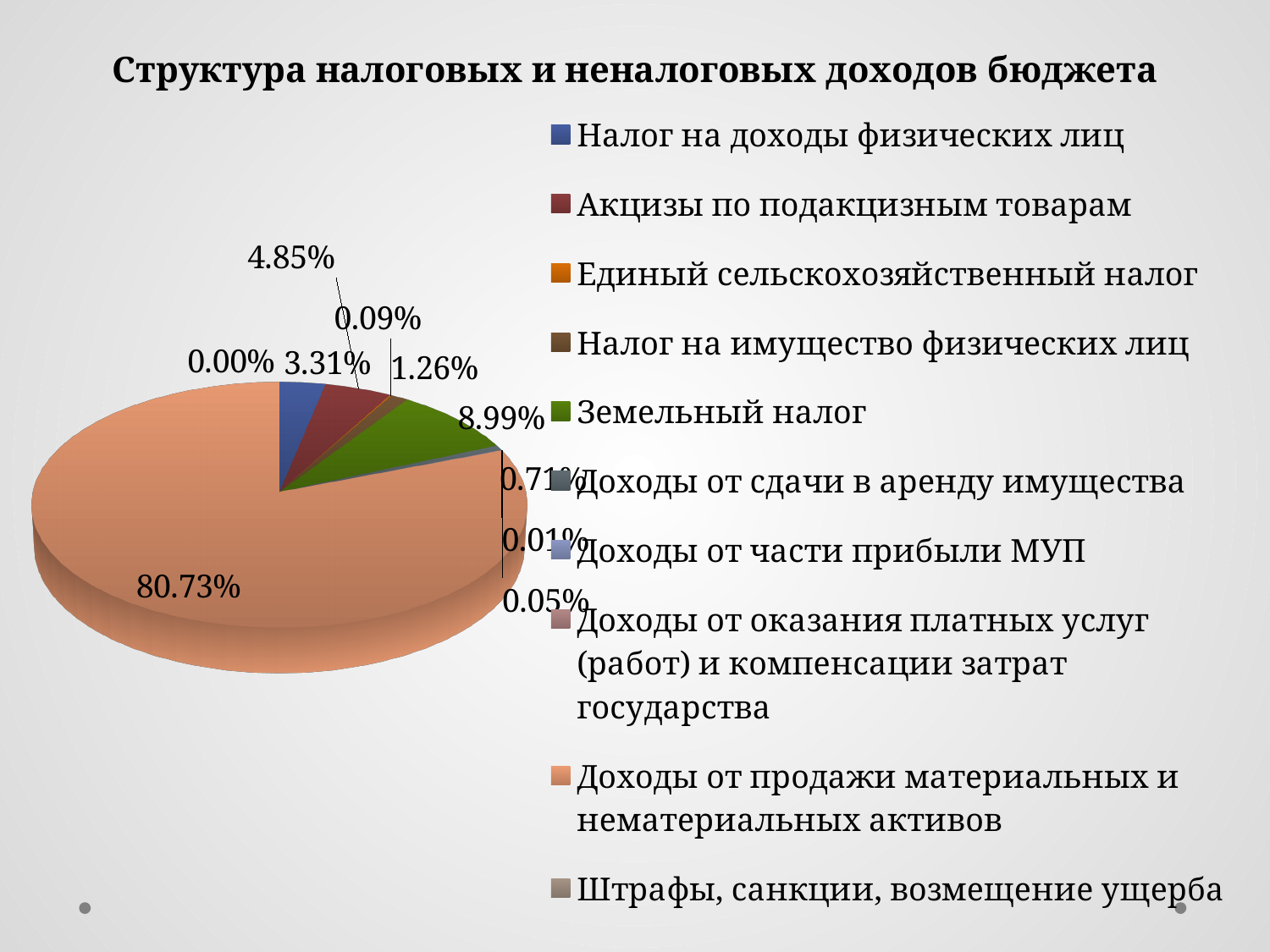
How many categories does the legend list? 10 What share does Земельный налог have? 8.99% Which is larger: the share of Земельный налог or the share of Налог на доходы физических лиц? Земельный налог What is the difference between the largest slice (80.73%) and the Земельный налог slice (8.99%)? 71.74% What is the largest share shown in the pie chart? 80.73% What is the smallest percentage value labelled on the chart? 0.00% What is the title of the chart? Структура налоговых и неналоговых доходов бюджета Which category has the largest share of the pie? Доходы от продажи материальных и нематериальных активов What share does Акцизы по подакцизным товарам have? 4.85% What type of chart is shown on the slide? pie chart What colour is the slice for Доходы от продажи материальных и нематериальных активов? orange (salmon) What share does Налог на доходы физических лиц have? 3.31%